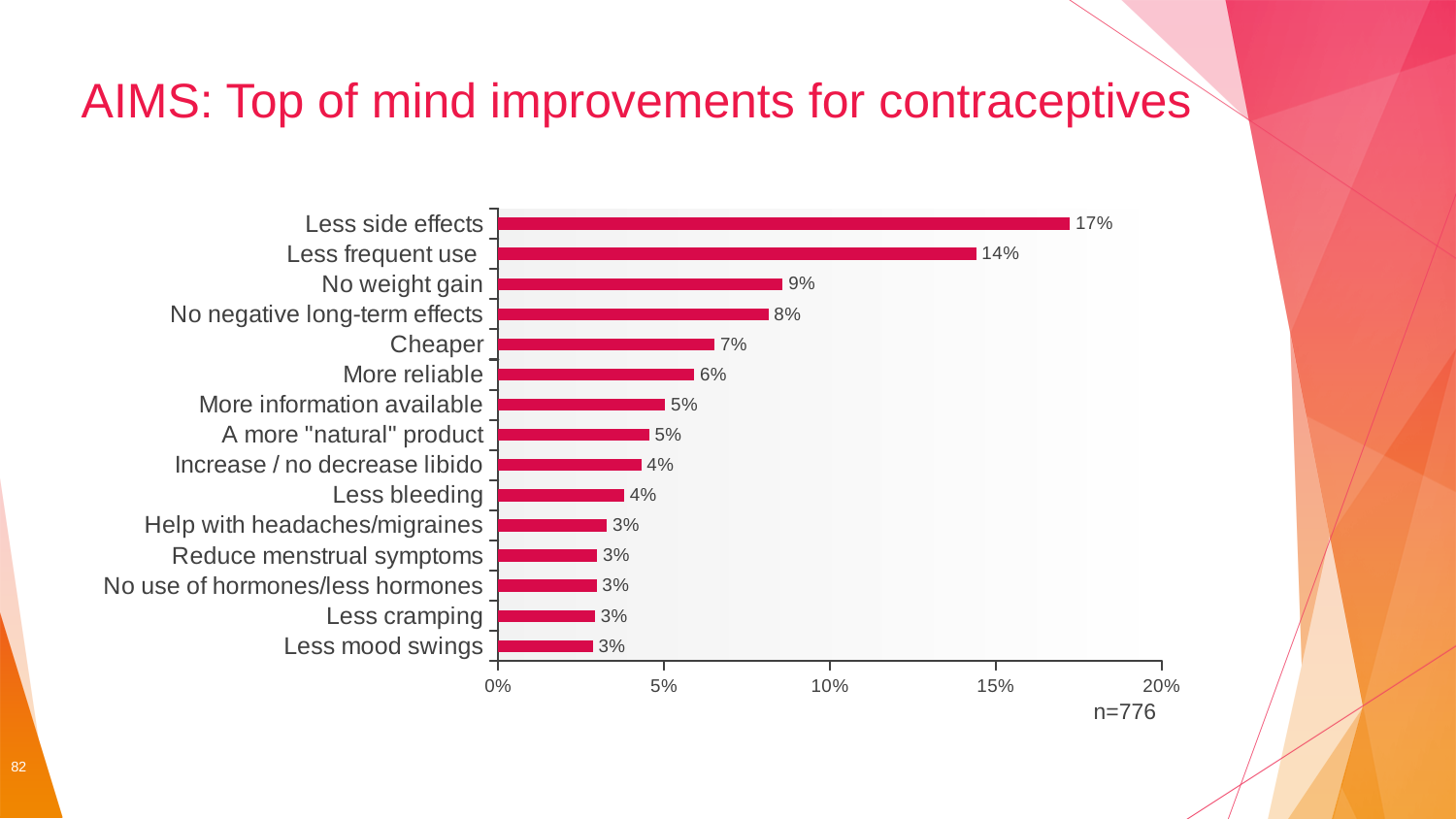
How many categories are shown in the chart? 15 What is the value for "Cheaper"? 7% What is the difference between "Less side effects" and "Less frequent use"? 3% Is the value for "Less bleeding" greater or less than 5%? less Which is larger, "No negative long-term effects" or "More information available"? No negative long-term effects What is the value for "Less side effects"? 17% What is the value for "No weight gain"? 9% What is the difference between "No weight gain" and "More reliable"? 3% What is the sample size noted below the chart? n=776 Is the value for "Less frequent use" greater or less than 10%? greater Which category has the highest value? Less side effects What kind of chart is shown on the slide? Bar chart